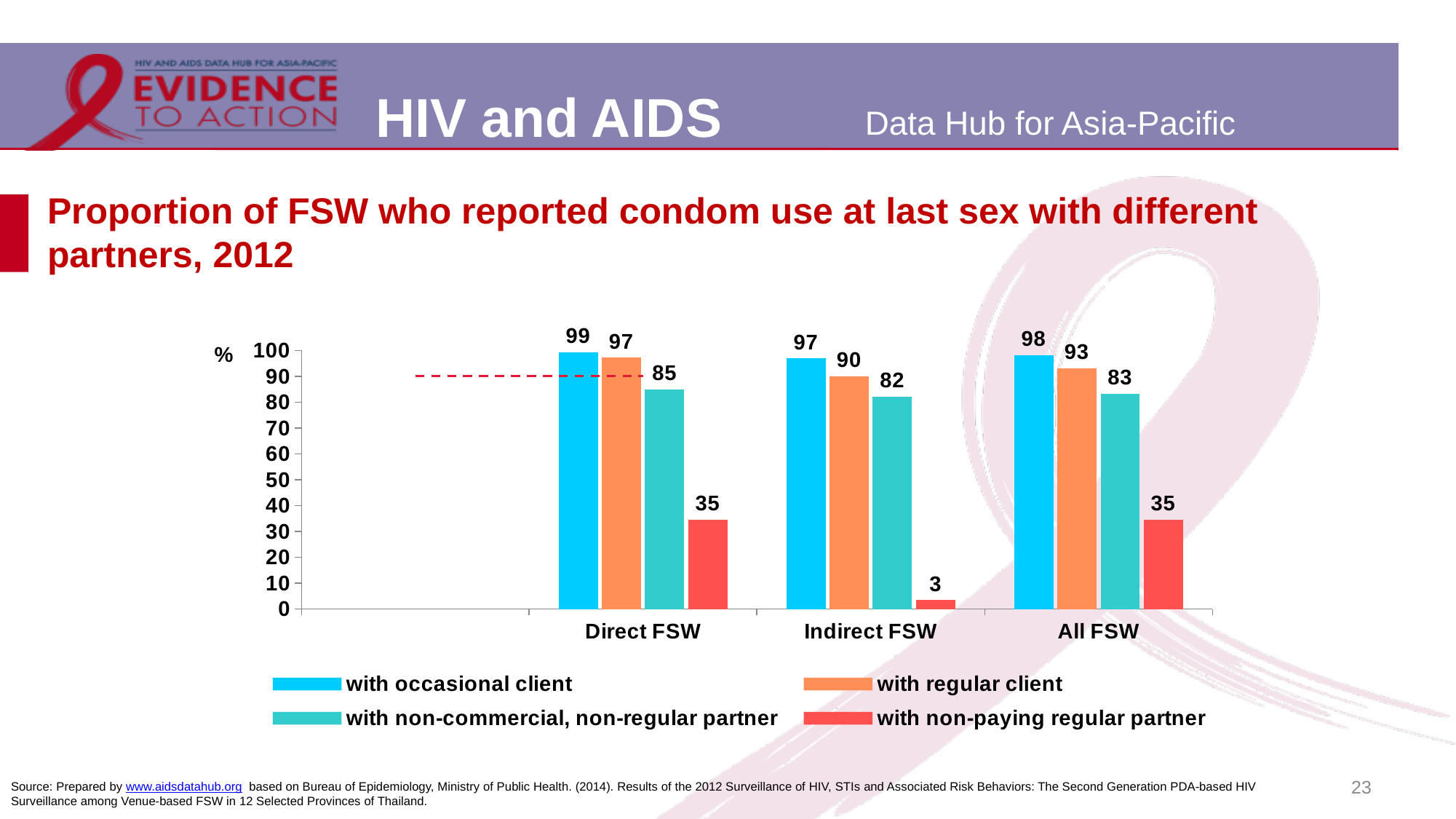
What is the difference between the 'with occasional client' and 'with non-paying regular partner' values for Direct FSW? 64 How many series does the legend list? 4 Which category has the highest value for the 'with occasional client' series? Direct FSW How many categories are shown on the x axis? 3 What is the value for Direct FSW with occasional client? 99 What is the value for Indirect FSW with non-commercial, non-regular partner? 82 What is the title of the chart on the slide? Proportion of FSW who reported condom use at last sex with different partners, 2012 What kind of chart is shown on the slide? Bar chart What is the value for All FSW with regular client? 93 Which is larger for Indirect FSW: the value with regular client or the value with non-commercial, non-regular partner? with regular client Which category has the lowest value for the 'with non-paying regular partner' series? Indirect FSW What is the value for Indirect FSW with non-paying regular partner? 3